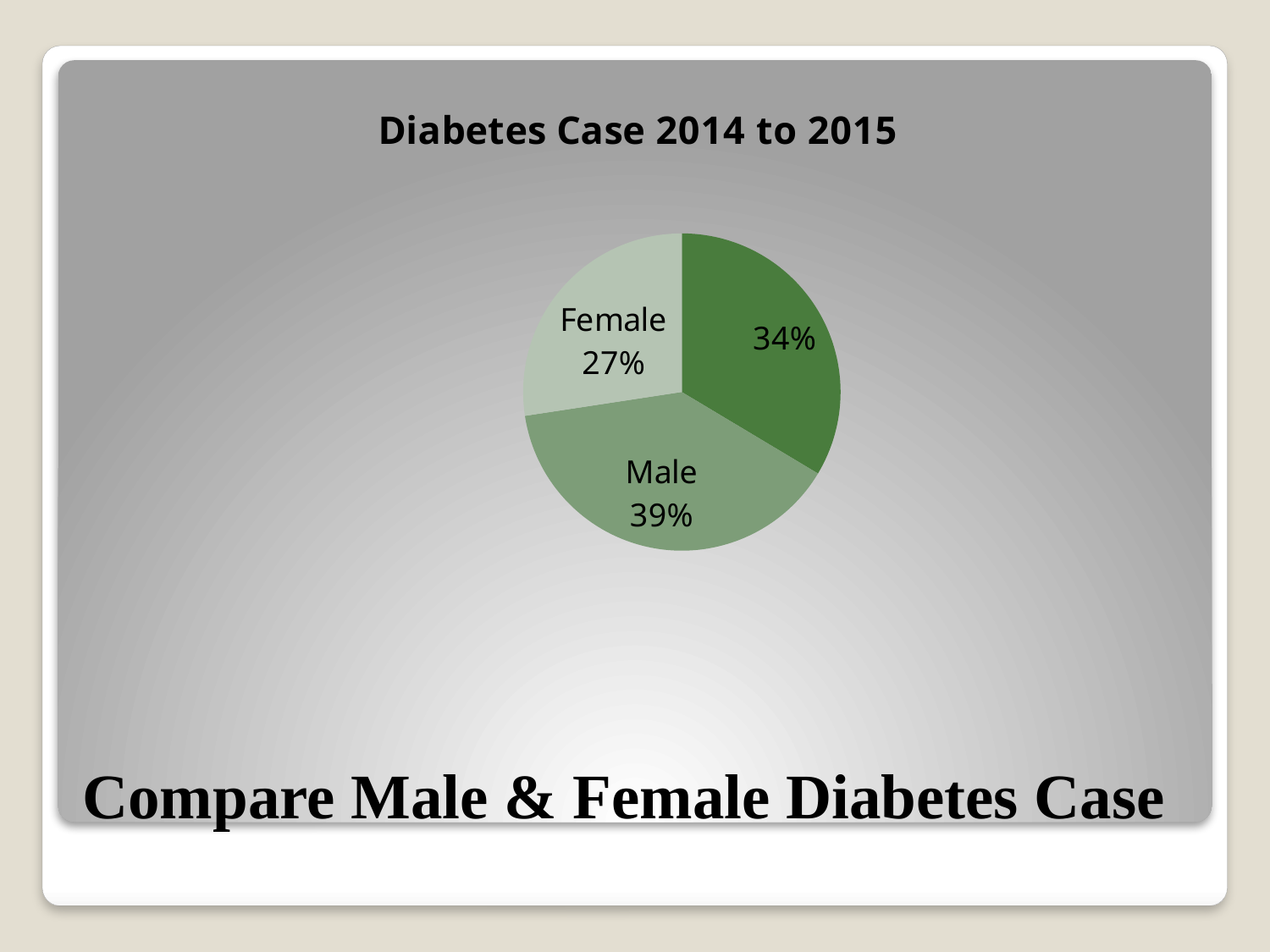
What is the title of the chart? Diabetes Case 2014 to 2015 What is the combined share of the Male and Female slices? 66% How many slices does the pie chart have? 3 What percentage of the pie is the Female slice? 27% Which is larger, the Male slice or the Female slice? Male Which slice of the pie is the largest? Male What is the share of the pie shown for the slice labelled only with a percentage (the darkest green slice)? 34% What is the difference in percentage points between the Male slice and the Female slice? 12 What kind of chart is shown on the slide? pie chart Which slice of the pie is the smallest? Female What is the text written below the chart on the slide? Compare Male & Female Diabetes Case What percentage of the pie is the Male slice? 39%